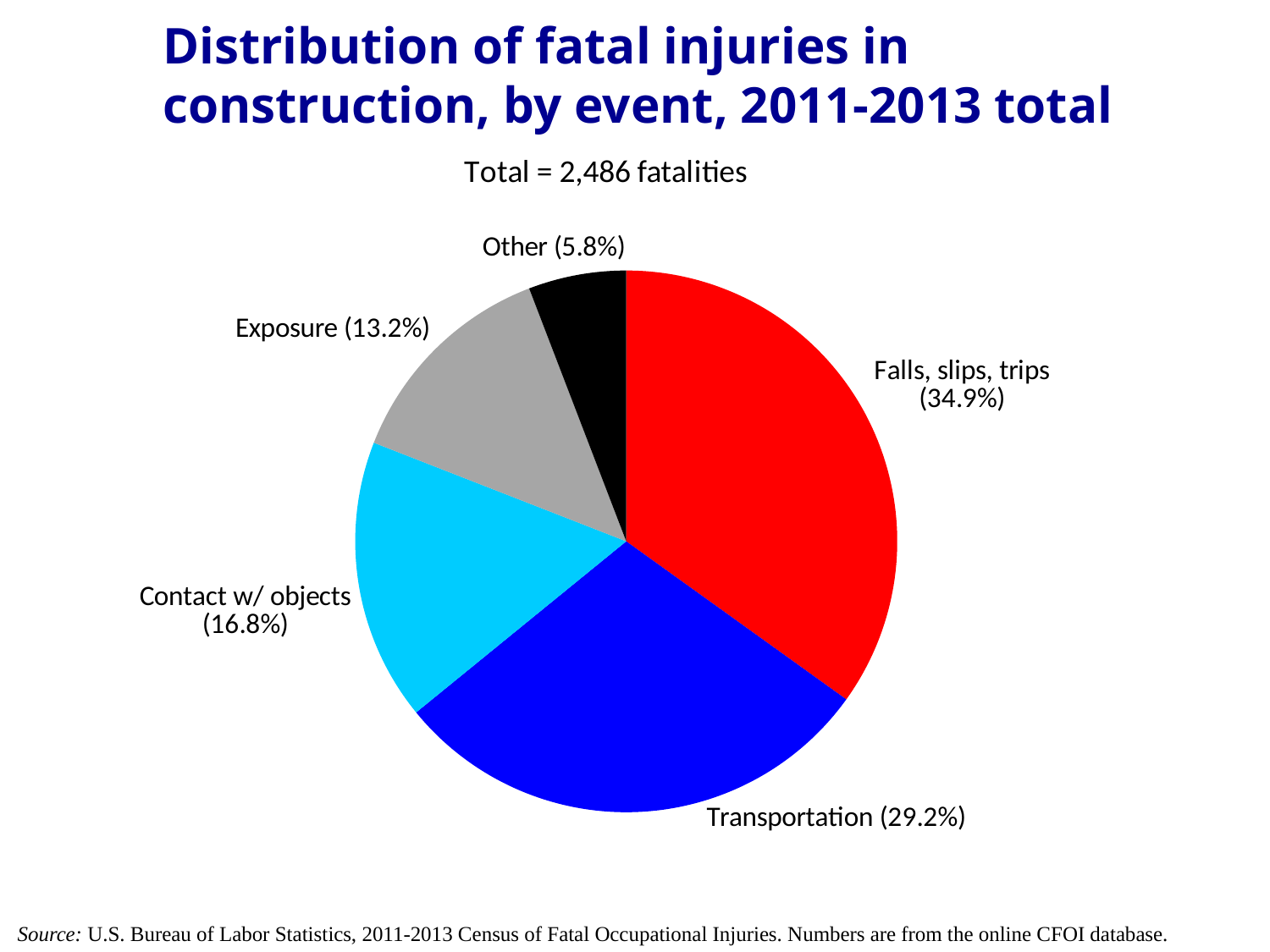
What kind of chart is shown on the slide? pie chart What percentage is shown for the Other slice? 5.8% Which event category has the smallest share of fatal injuries? Other What share of fatal injuries in construction is attributed to Falls, slips, trips? 34.9% What total number of fatalities does the chart state? 2,486 fatalities What is the difference in percentage points between Falls, slips, trips and Transportation? 5.7 What share does Contact w/ objects account for? 16.8% How many slices does the pie chart have? 5 Which is larger, the share for Exposure or the share for Contact w/ objects? Contact w/ objects Which event category has the largest share of fatal injuries? Falls, slips, trips What percentage is shown for Exposure? 13.2% What percentage of the pie is Transportation? 29.2%